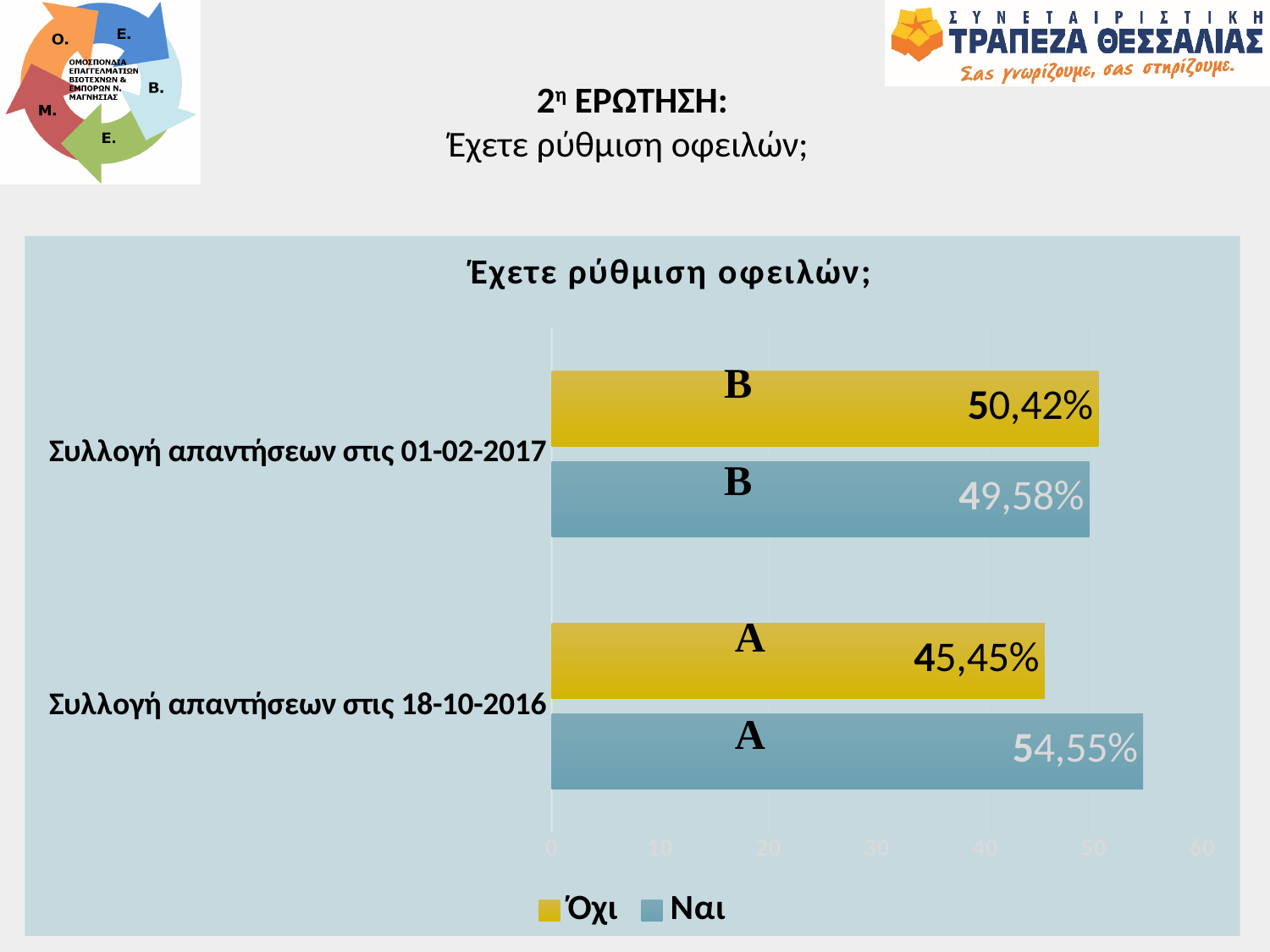
Which category has the highest Ναι value? Συλλογή απαντήσεων στις 18-10-2016 Which is larger for Συλλογή απαντήσεων στις 18-10-2016, Όχι or Ναι? Ναι How many categories are shown on the chart? 2 What is the difference between Ναι and Όχι for Συλλογή απαντήσεων στις 18-10-2016? 9,10% What is the value of Όχι for Συλλογή απαντήσεων στις 01-02-2017? 50,42% How many series does the legend list? 2 What type of chart is shown on the slide? bar chart What is the title of the chart? Έχετε ρύθμιση οφειλών; Which colour represents the Όχι series in the legend? yellow What is the value of Ναι for Συλλογή απαντήσεων στις 18-10-2016? 54,55% What is the value of Ναι for Συλλογή απαντήσεων στις 01-02-2017? 49,58% What is the value of Όχι for Συλλογή απαντήσεων στις 18-10-2016? 45,45%